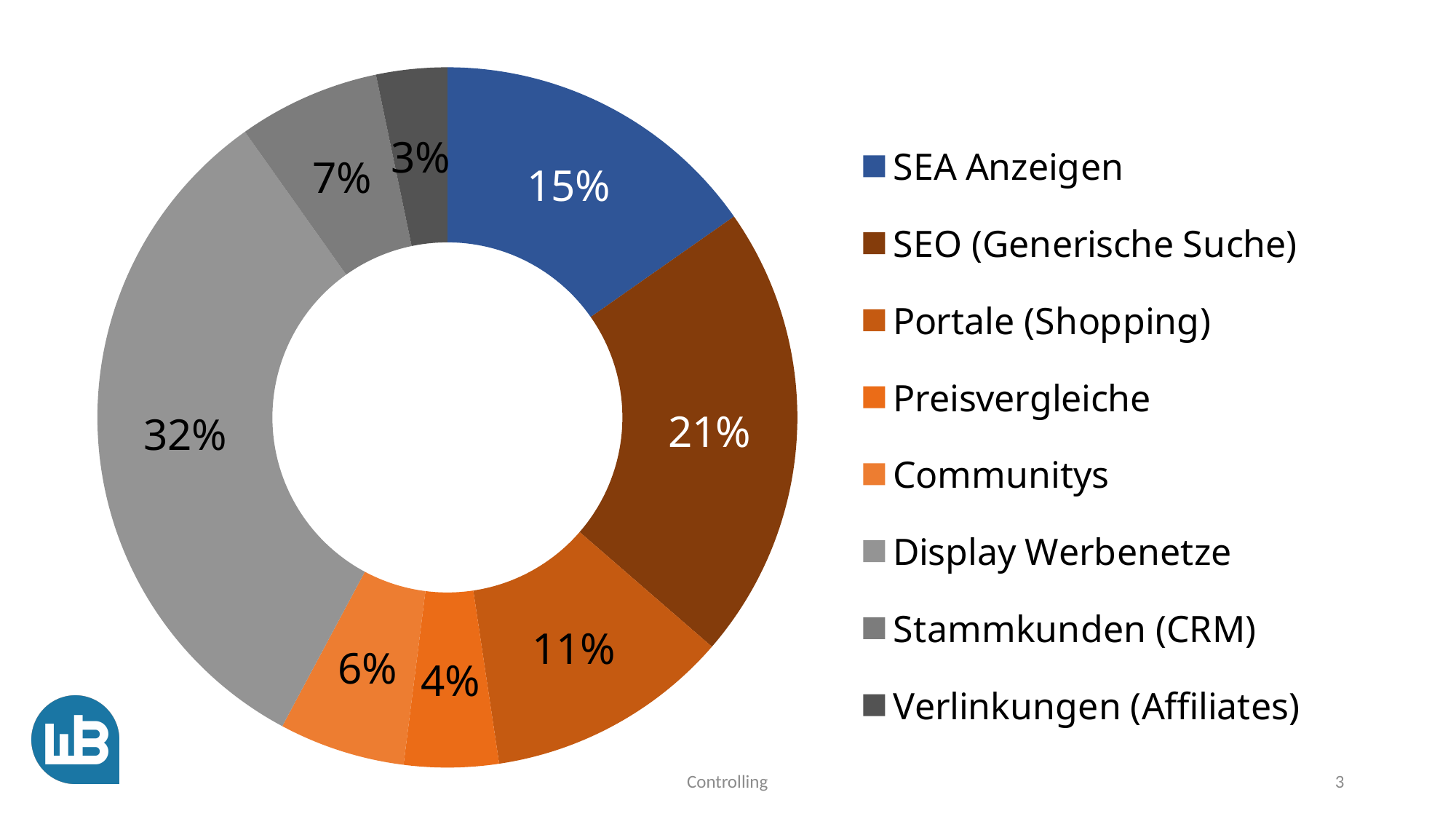
What colour is the slice for SEA Anzeigen? blue Which has the larger share, Portale (Shopping) or Communitys? Portale (Shopping) What percentage does the chart show for Preisvergleiche? 4% Which category has the largest share in the chart? Display Werbenetze What percentage does the chart show for SEO (Generische Suche)? 21% How many categories does the chart show? 8 What percentage does the chart show for Display Werbenetze? 32% What kind of chart is shown on the slide? doughnut chart Which category has the smallest share in the chart? Verlinkungen (Affiliates) What percentage does the chart show for Stammkunden (CRM)? 7% What percentage does the chart show for SEA Anzeigen? 15% What is the difference in percentage points between Display Werbenetze and SEO (Generische Suche)? 11